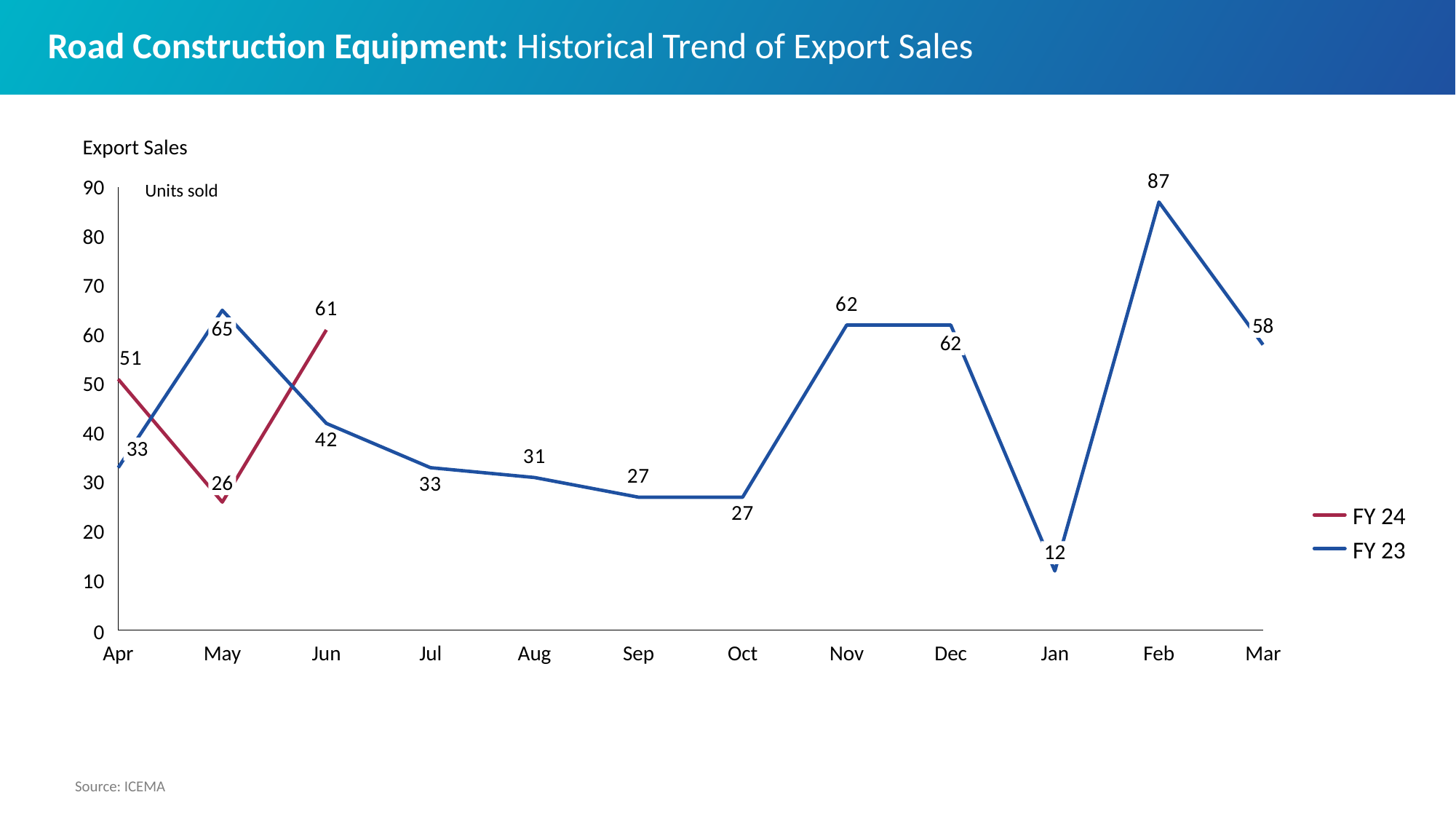
Which is larger in May, the FY 23 value or the FY 24 value? FY 23 What unit is indicated for the y axis? Units sold How many series does the legend list? 2 What is the FY 23 export sales value for Feb? 87 What is the difference between the FY 24 and FY 23 values for Apr? 18 What is the FY 24 export sales value for Jun? 61 What is the FY 23 export sales value for Jan? 12 How many months are shown on the x axis? 12 In which month is the FY 23 value lowest? Jan What kind of chart is shown on the slide? Line chart Does the FY 23 line rise or fall from Jun to Sep? Fall In which month is the FY 23 value highest? Feb